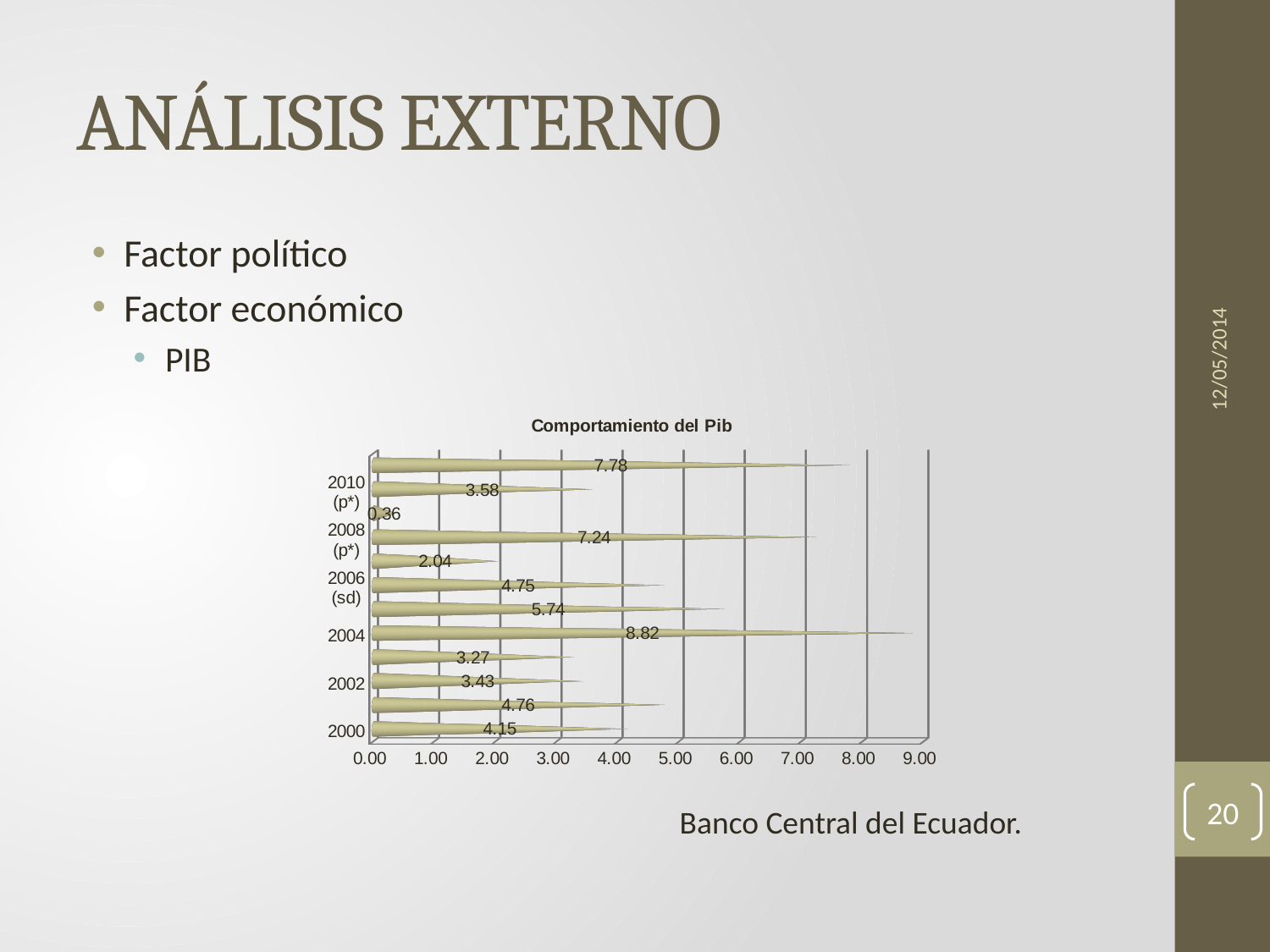
What is the value for 2010 (p*) in the chart? 3.58 Which is larger, the value for 2008 (p*) or the value for 2010 (p*)? 2008 (p*) What is the value for 2002 in the chart? 3.43 What type of chart is shown on the slide? bar chart What is the title of the chart? Comportamiento del Pib What is the value for 2006 (sd) in the chart? 4.75 What is the value for 2000 in the chart? 4.15 Which labeled year has the highest value in the chart? 2004 What is the value for 2004 in the chart? 8.82 What is the value for 2008 (p*) in the chart? 7.24 What is the difference between the values for 2004 and 2000? 4.67 What is the lowest value printed on the chart? 0.36